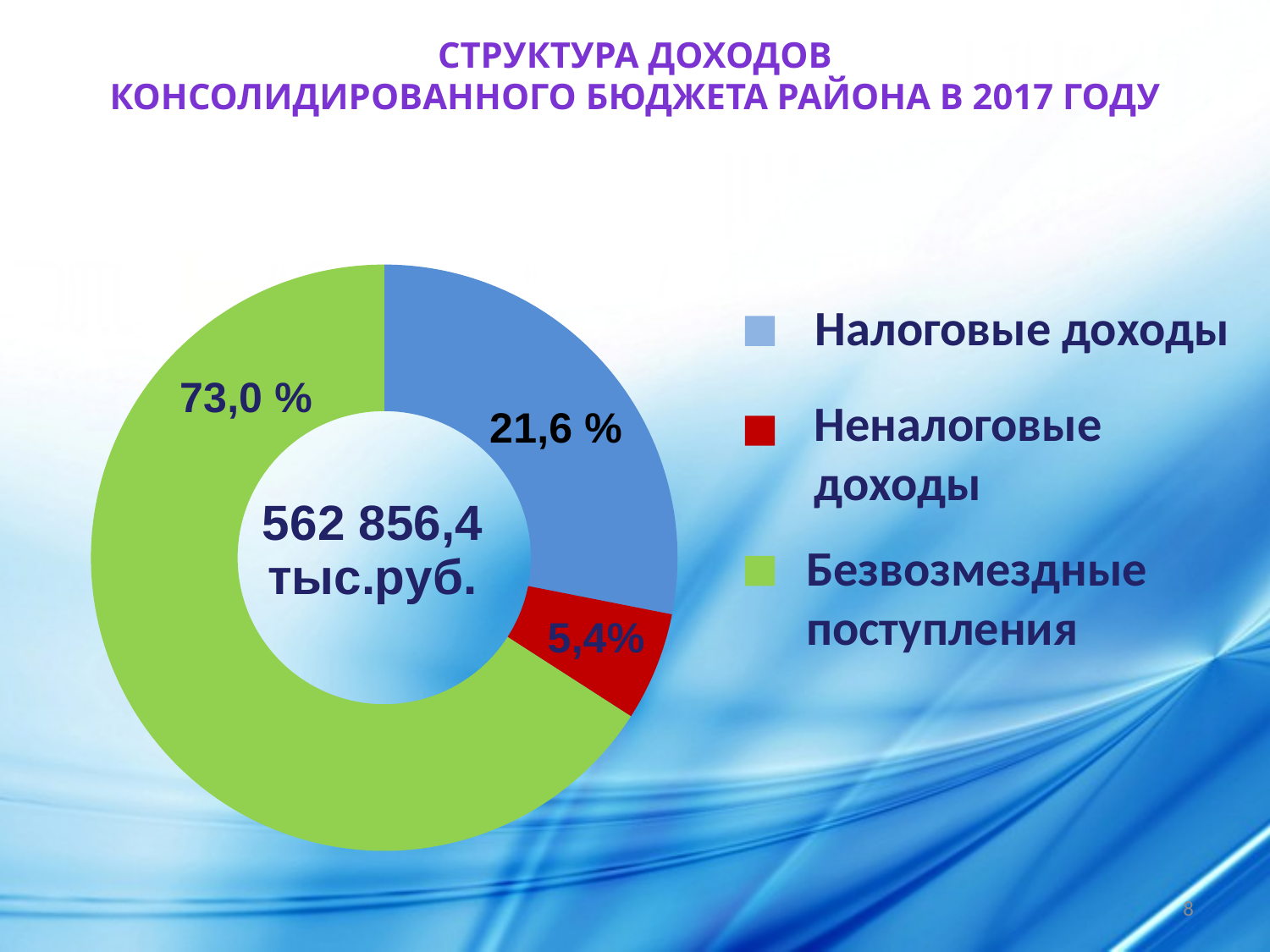
Which category has the smallest share of the chart? Неналоговые доходы What share of the chart does Налоговые доходы represent? 21,6 % Which category has the largest share of the chart? Безвозмездные поступления Which colour represents Безвозмездные поступления in the legend? Green What total value is printed in the centre of the chart? 562 856,4 тыс.руб. What share of the chart does Неналоговые доходы represent? 5,4% What kind of chart is shown on the slide? Pie chart (doughnut) What is the difference in percentage points between the share for Безвозмездные поступления and the share for Налоговые доходы? 51,4 What share of the chart does Безвозмездные поступления represent? 73,0 % What is the difference in percentage points between the share for Налоговые доходы and the share for Неналоговые доходы? 16,2 Which is larger: the share for Налоговые доходы or the share for Неналоговые доходы? Налоговые доходы How many categories does the chart show? 3